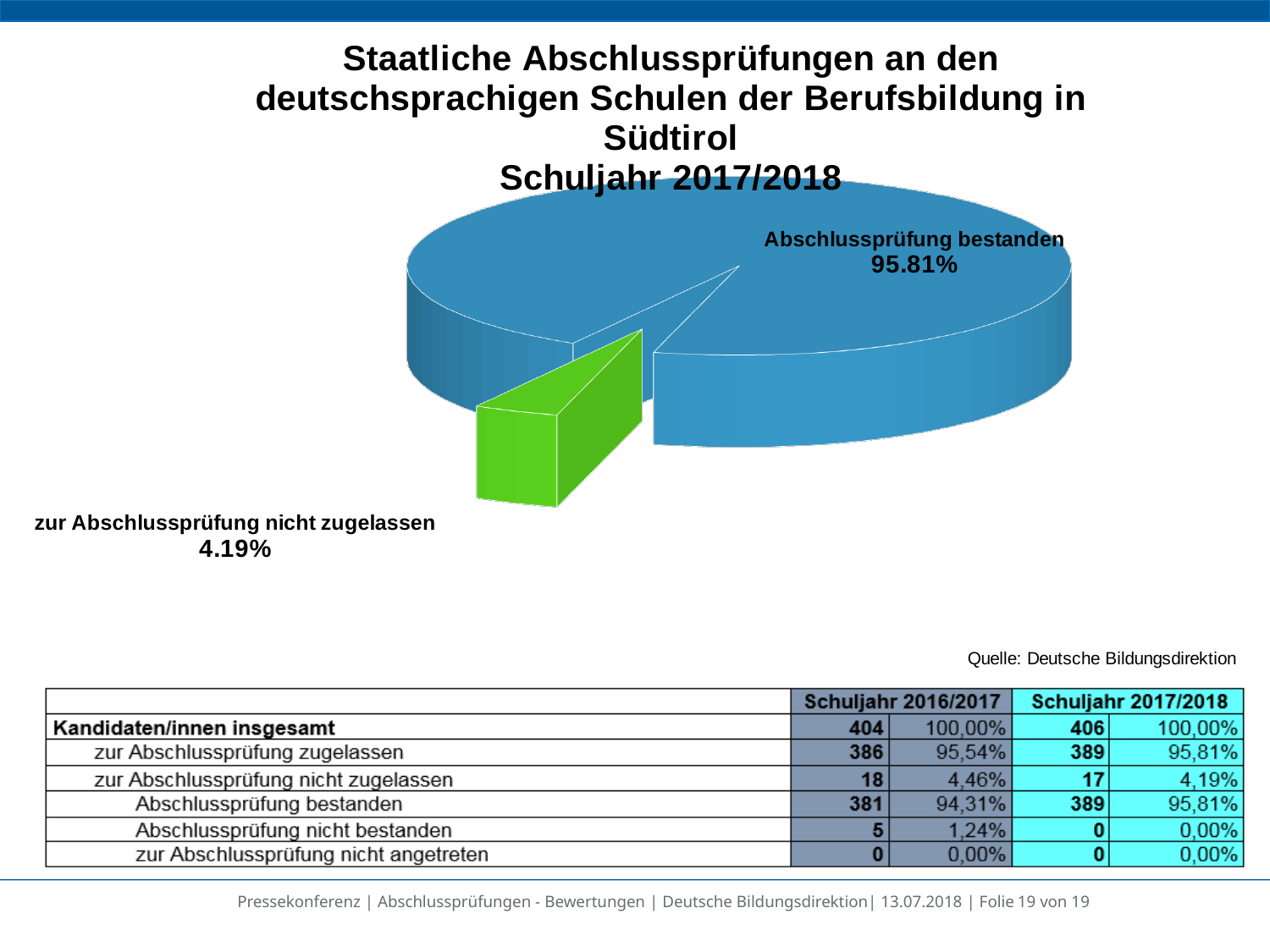
Which school year does the chart title refer to? Schuljahr 2017/2018 Which slice of the pie chart is the largest? Abschlussprüfung bestanden How many slices does the pie chart have? 2 Which is larger in the pie chart: "Abschlussprüfung bestanden" or "zur Abschlussprüfung nicht zugelassen"? Abschlussprüfung bestanden What share of the pie chart is labelled "zur Abschlussprüfung nicht zugelassen"? 4.19% Which slice of the pie chart is the smallest? zur Abschlussprüfung nicht zugelassen What kind of chart is shown on the slide? pie chart Is the share for "zur Abschlussprüfung nicht zugelassen" greater or less than 5%? less What do the two slice percentages in the pie chart add up to? 100% By how many percentage points is the "Abschlussprüfung bestanden" slice larger than the "zur Abschlussprüfung nicht zugelassen" slice? 91.62 percentage points What colour is the "zur Abschlussprüfung nicht zugelassen" slice in the pie chart? green What share of the pie chart is labelled "Abschlussprüfung bestanden"? 95.81%